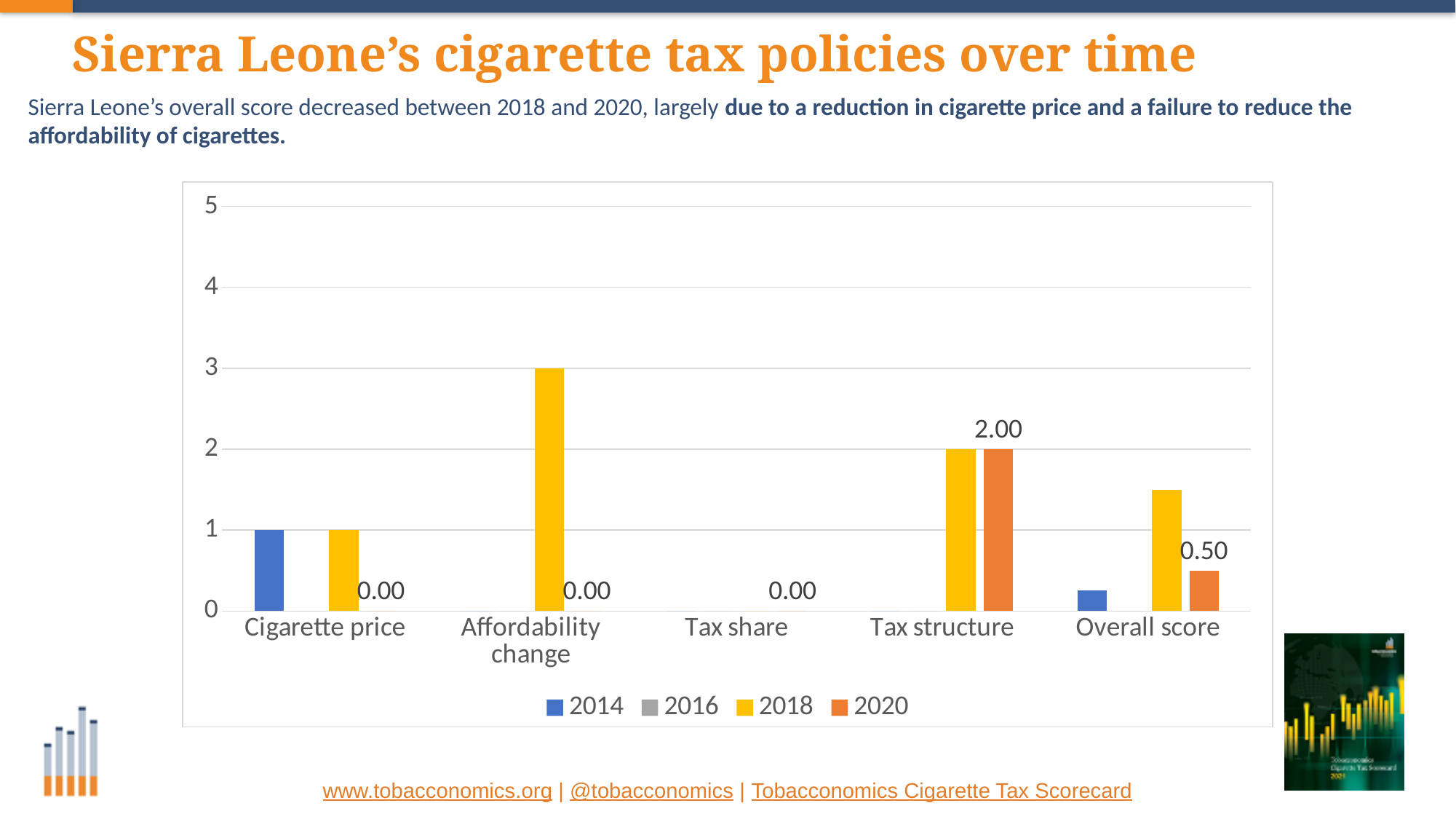
What is the 2020 value for Tax structure? 2.00 What is the 2020 value for Cigarette price? 0.00 How many series does the legend list? 4 Which category has the highest 2018 value? Affordability change What is the 2018 value for Affordability change? 3 What is the 2020 value for Overall score? 0.50 For Overall score, which year has the larger value, 2018 or 2020? 2018 Is the 2014 value for Overall score greater or less than 1? less What is the difference between the 2020 values for Tax structure and Overall score? 1.50 What kind of chart is shown on the slide? bar chart How many categories are shown on the x axis? 5 Is the 2018 value for Overall score greater or less than 1? greater